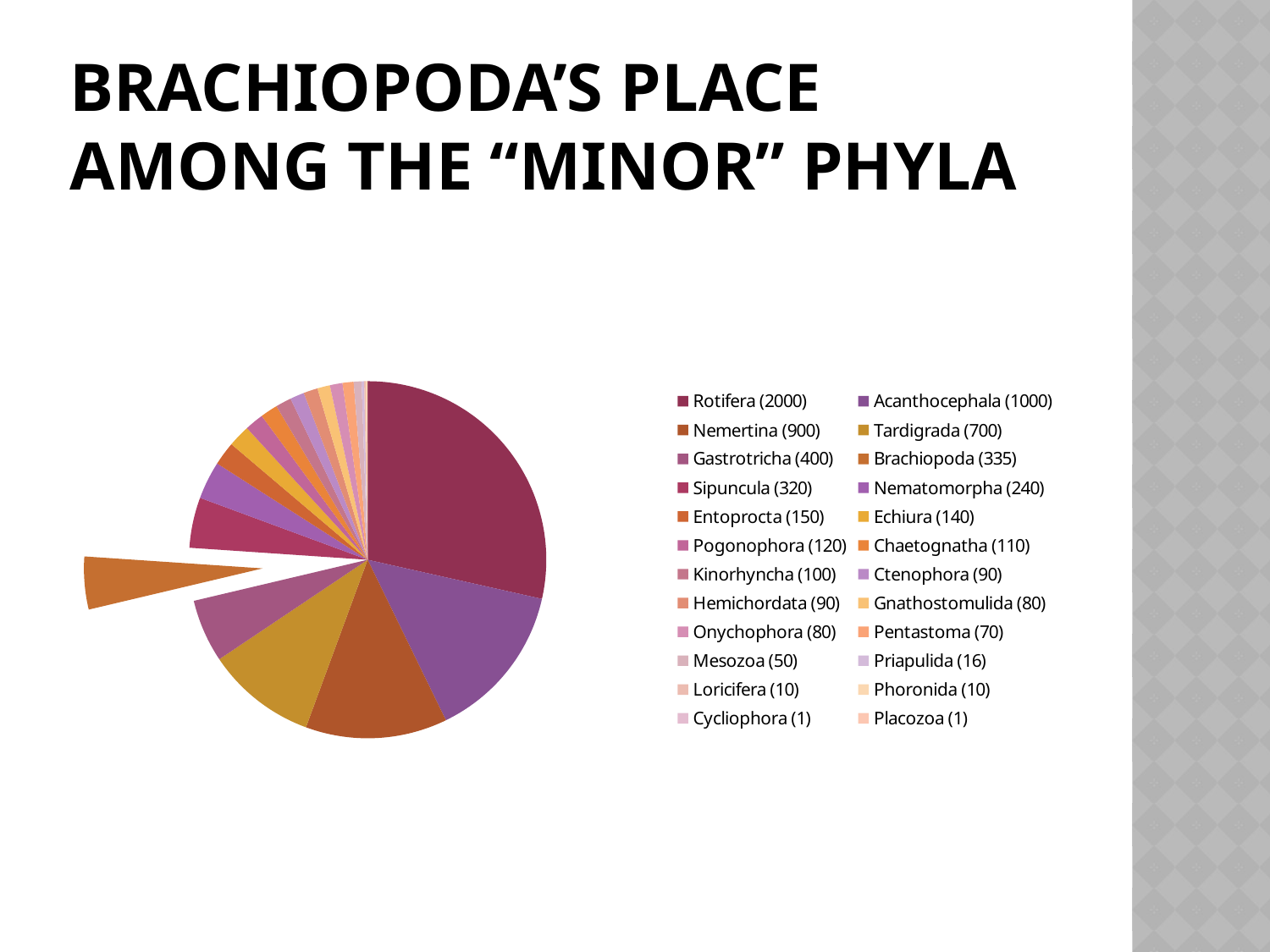
What kind of chart is shown on the slide? pie chart What value is given for Nematomorpha in the legend? 240 Which has the larger value, Gastrotricha or Entoprocta? Gastrotricha What value is given for Brachiopoda in the legend? 335 What is the difference between the values for Brachiopoda and Sipuncula? 15 How many phyla are listed in the legend of the pie chart? 24 What value is given for Rotifera in the legend? 2000 Which phylum's slice is pulled out (exploded) from the pie? Brachiopoda Which phylum has the largest slice of the pie? Rotifera What is the difference between the values for Rotifera and Acanthocephala? 1000 Which has the larger value, Nemertina or Tardigrada? Nemertina What value is given for Priapulida in the legend? 16